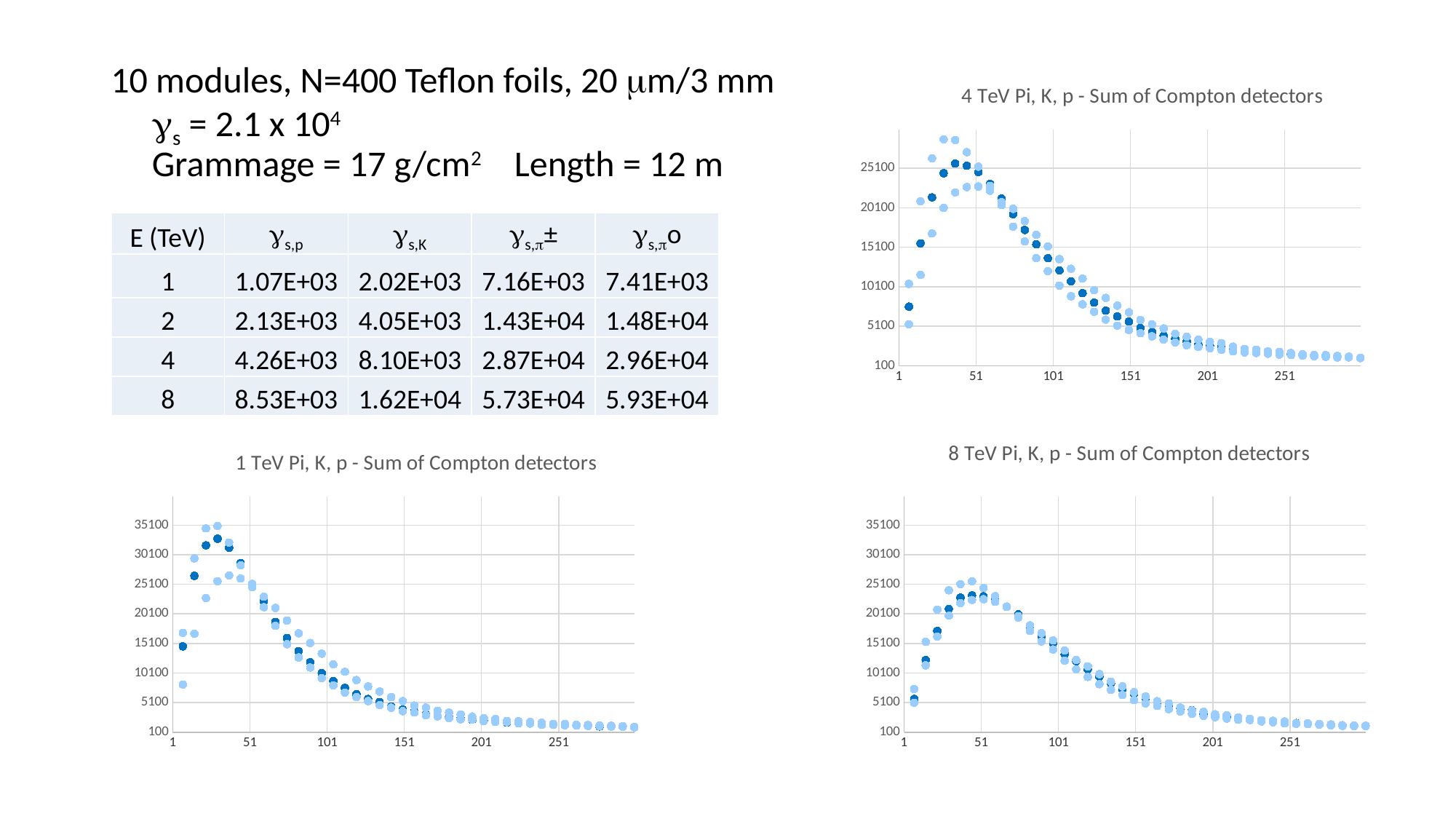
What is the title of the chart in the top right of the slide? 4 TeV Pi, K, p - Sum of Compton detectors What kind of chart is the '1 TeV Pi, K, p - Sum of Compton detectors' chart? scatter chart In the '4 TeV Pi, K, p - Sum of Compton detectors' chart, are the values near x = 151 greater or less than 10100? less In the '8 TeV Pi, K, p - Sum of Compton detectors' chart, is the highest plotted value greater or less than 30100? less In the '4 TeV Pi, K, p - Sum of Compton detectors' chart, is the highest plotted value greater or less than 25100? greater What is the highest tick label on the y axis of the '4 TeV Pi, K, p - Sum of Compton detectors' chart? 25100 How many charts are shown on the slide? 3 In the '1 TeV Pi, K, p - Sum of Compton detectors' chart, do the values rise or fall along the x axis after the peak near x = 51? fall